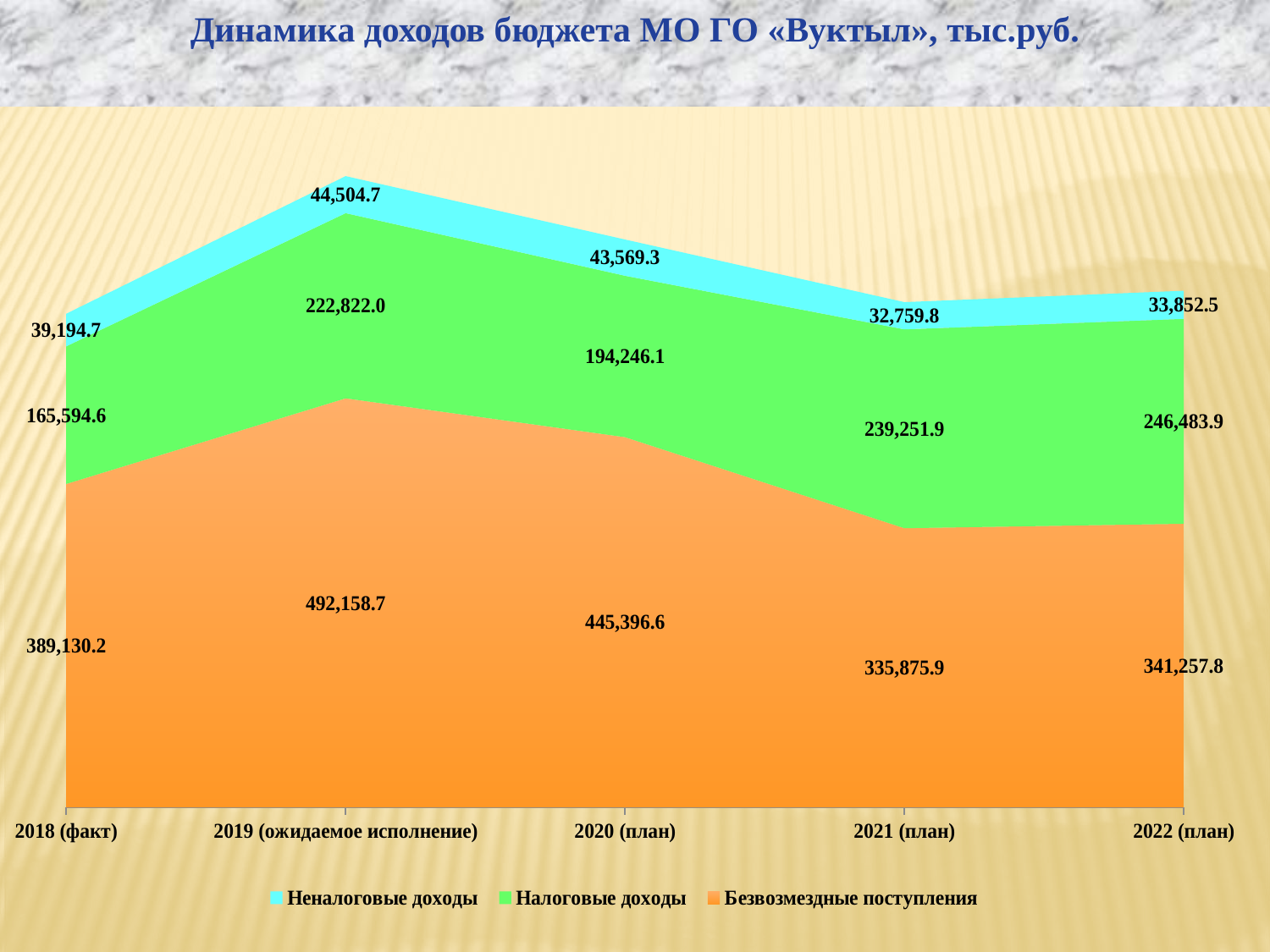
How many series does the legend list? 3 What is the value of Налоговые доходы for 2020 (план)? 194,246.1 In which year is Налоговые доходы lowest? 2018 (факт) Which series is shown in orange? Безвозмездные поступления How many years are shown on the x axis? 5 What kind of chart is this? Stacked area chart What is the difference between Налоговые доходы in 2022 (план) and in 2018 (факт)? 80,889.3 Which is larger: Неналоговые доходы in 2019 (ожидаемое исполнение) or in 2020 (план)? 2019 (ожидаемое исполнение) What is the value of Неналоговые доходы for 2021 (план)? 32,759.8 What is the value of Безвозмездные поступления for 2018 (факт)? 389,130.2 What is the total of all three series for 2018 (факт)? 593,919.5 In which year is Безвозмездные поступления highest? 2019 (ожидаемое исполнение)